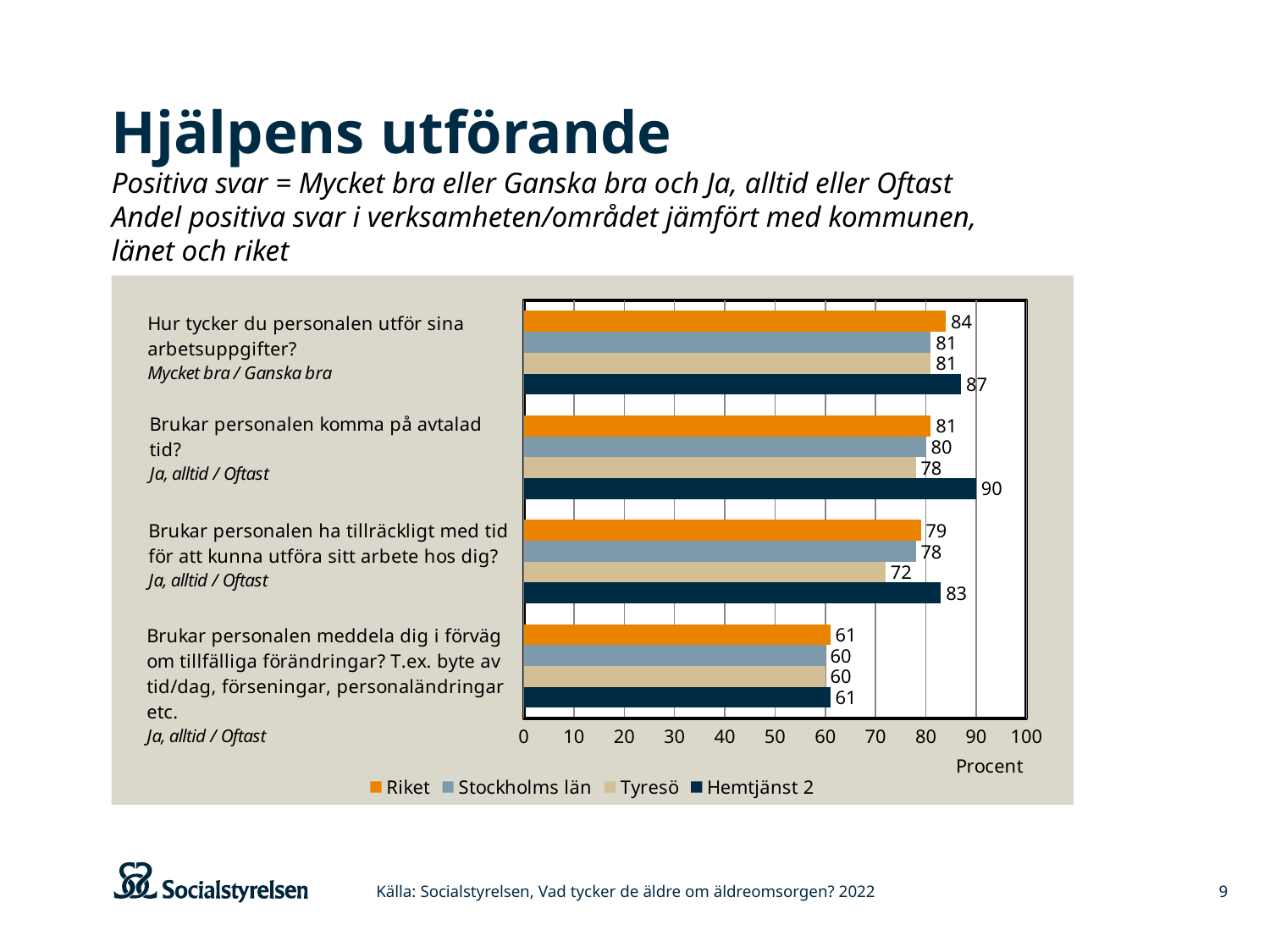
What is the value for Stockholms län for the question "Brukar personalen meddela dig i förväg om tillfälliga förändringar?"? 60 Which series has the highest value for the question "Brukar personalen komma på avtalad tid?"? Hemtjänst 2 What is the value for Riket for the question "Hur tycker du personalen utför sina arbetsuppgifter?"? 84 What is the difference between Hemtjänst 2 and Tyresö for the question "Brukar personalen komma på avtalad tid?"? 12 How many question categories are plotted in the chart? 4 What type of chart is shown on the slide? bar chart What is the label on the x axis of the chart? Procent Which is larger for the question "Hur tycker du personalen utför sina arbetsuppgifter?": Riket or Hemtjänst 2? Hemtjänst 2 Which series has the lowest value for the question "Brukar personalen ha tillräckligt med tid för att kunna utföra sitt arbete hos dig?"? Tyresö What is the value for Tyresö for the question "Brukar personalen ha tillräckligt med tid för att kunna utföra sitt arbete hos dig?"? 72 How many series does the legend list? 4 What is the value for Hemtjänst 2 for the question "Brukar personalen komma på avtalad tid?"? 90